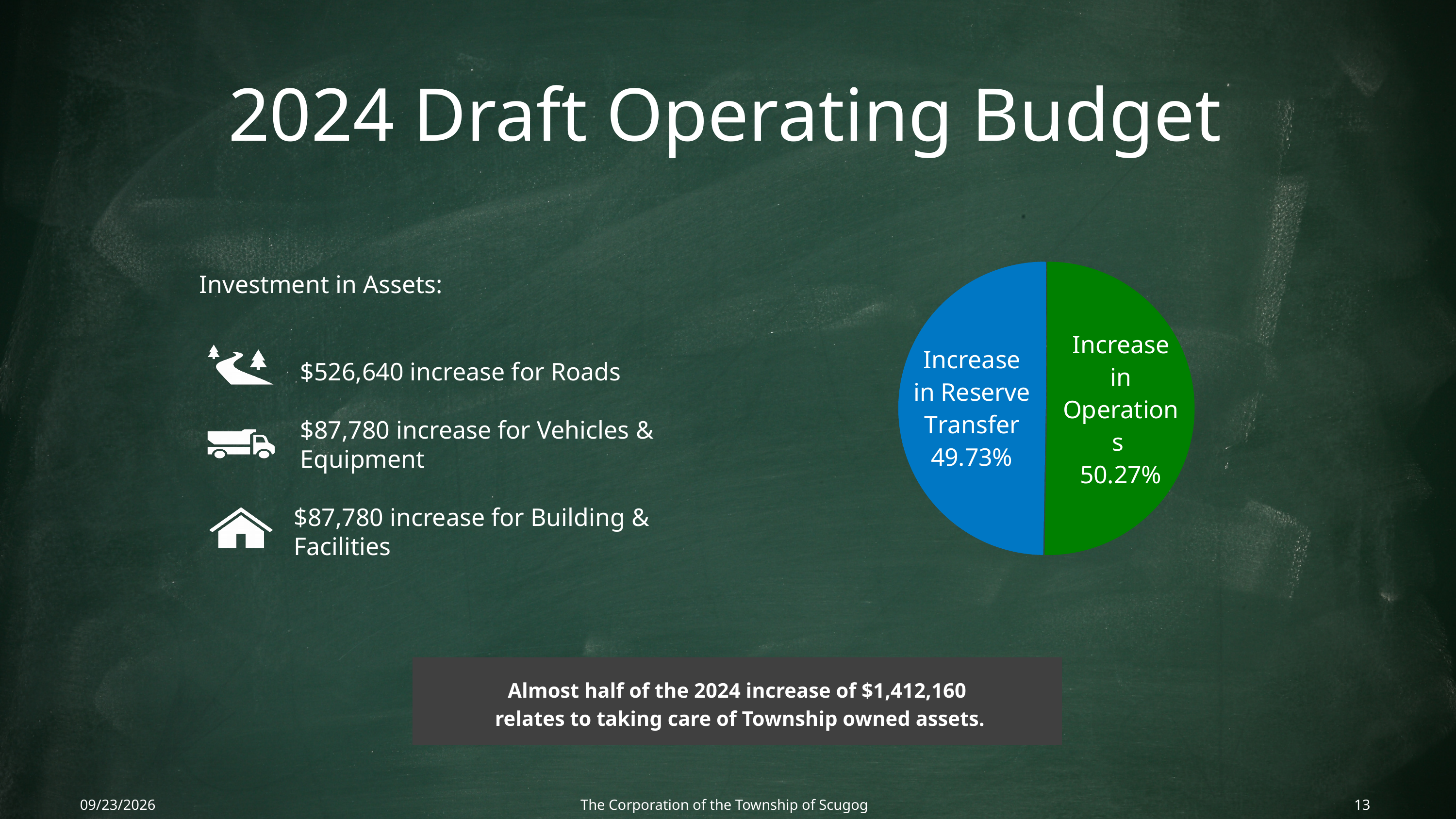
What share of the pie chart is labelled Increase in Reserve Transfer? 49.73% Is the Increase in Reserve Transfer slice greater or less than 50% of the pie chart? less What colour is the Increase in Reserve Transfer slice of the pie chart? Blue How many slices does the pie chart have? 2 Is the Increase in Operations slice greater or less than 50% of the pie chart? greater Which slice of the pie chart is the largest? Increase in Operations What is the difference in percentage points between the Increase in Operations slice and the Increase in Reserve Transfer slice? 0.54% Which slice of the pie chart is the smallest? Increase in Reserve Transfer What colour is the Increase in Operations slice of the pie chart? Green What share of the pie chart is labelled Increase in Operations? 50.27% What kind of chart is shown on the slide? Pie chart Which is larger in the pie chart: Increase in Reserve Transfer or Increase in Operations? Increase in Operations